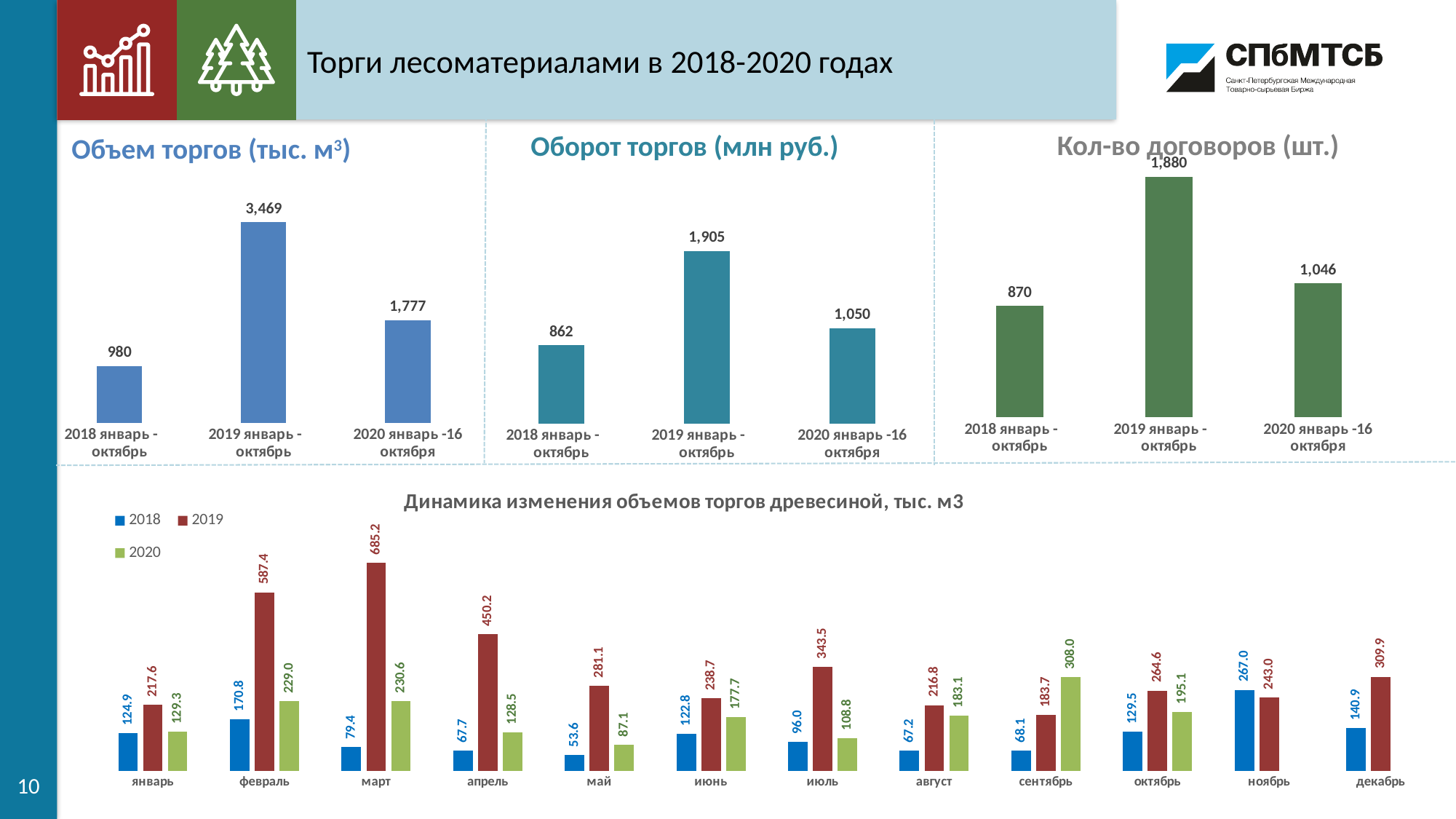
In the bottom chart titled 'Динамика изменения объемов торгов древесиной, тыс. м3', how many series does the legend list? 3 In the bottom chart titled 'Динамика изменения объемов торгов древесиной, тыс. м3', which month has the lowest value for 2018? май In the chart titled 'Оборот торгов (млн руб.)', what is the value for '2020 январь -16 октября'? 1,050 In the chart titled 'Кол-во договоров (шт.)', what is the difference between the values for '2020 январь -16 октября' and '2018 январь - октябрь'? 176 What type of chart is the chart titled 'Оборот торгов (млн руб.)'? Bar chart In the chart titled 'Объем торгов (тыс. м3)', how many bars are plotted? 3 In the bottom chart titled 'Динамика изменения объемов торгов древесиной, тыс. м3', what is the difference between the 2019 and 2018 values in февраль? 416.6 In the bottom chart titled 'Динамика изменения объемов торгов древесиной, тыс. м3', which is larger in ноябрь: the value for 2018 or for 2019? 2018 In the chart titled 'Объем торгов (тыс. м3)', what is the value for '2019 январь - октябрь'? 3,469 In the bottom chart titled 'Динамика изменения объемов торгов древесиной, тыс. м3', which month has the highest value for 2020? сентябрь In the chart titled 'Кол-во договоров (шт.)', which period has the highest value? 2019 январь - октябрь In the bottom chart titled 'Динамика изменения объемов торгов древесиной, тыс. м3', what is the value for 2019 in март? 685.2